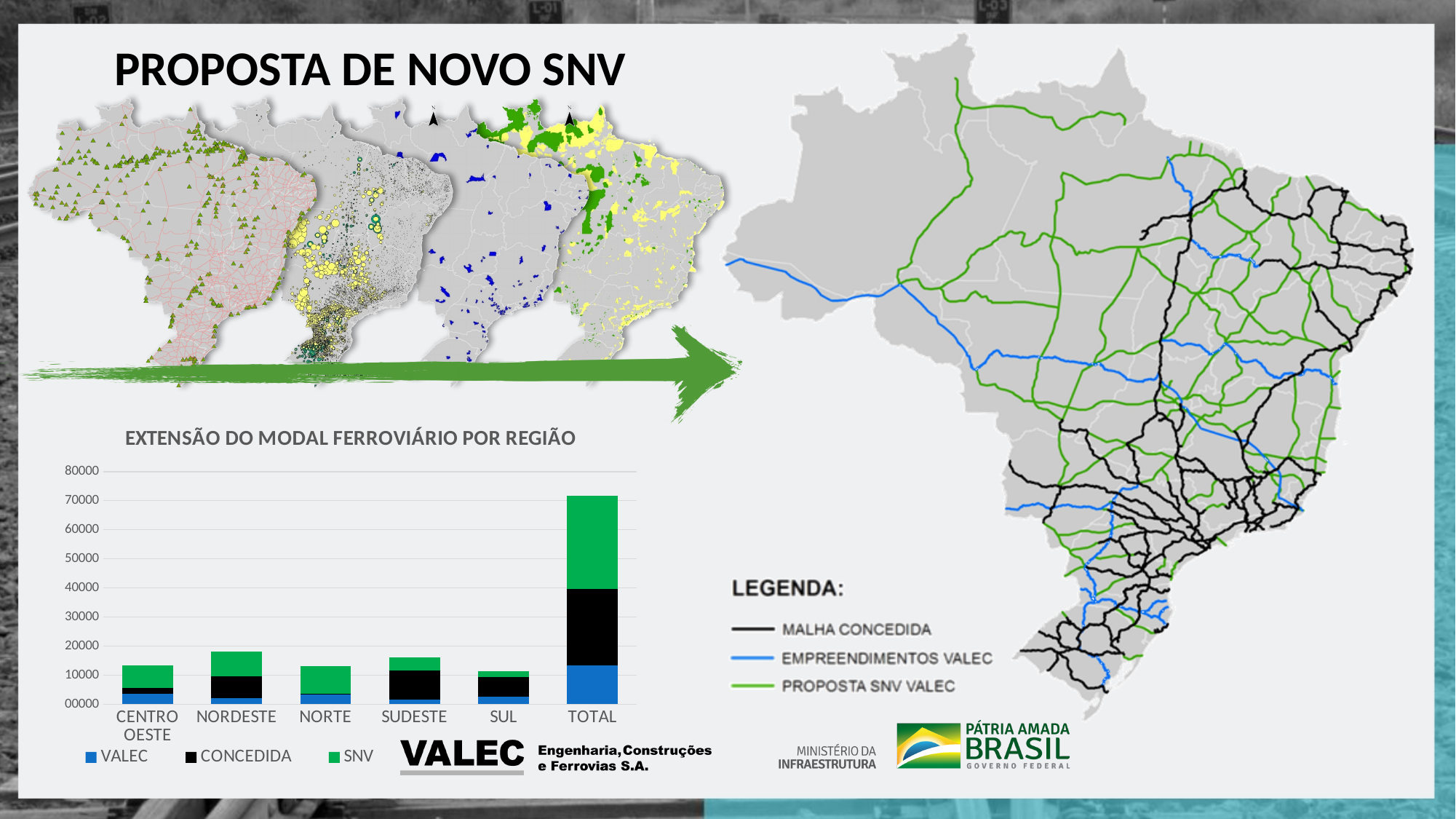
Which colour represents the CONCEDIDA series in the chart legend? Black Among the regions (excluding TOTAL), which has the shortest stacked bar? SUL How many series does the chart legend list? 3 Which stacked bar is taller, NORDESTE or SUL? NORDESTE Which series is the smallest segment in the TOTAL bar? VALEC Which category has the tallest stacked bar in the chart? TOTAL Is the total stacked value for TOTAL greater or less than 60000? greater What kind of chart is shown on the slide? Stacked bar chart Is the total stacked value for SUL greater or less than 20000? less Is the total stacked value for NORDESTE greater or less than 10000? greater How many categories are shown on the x axis of the chart? 6 What is the title of the chart on the slide? EXTENSÃO DO MODAL FERROVIÁRIO POR REGIÃO